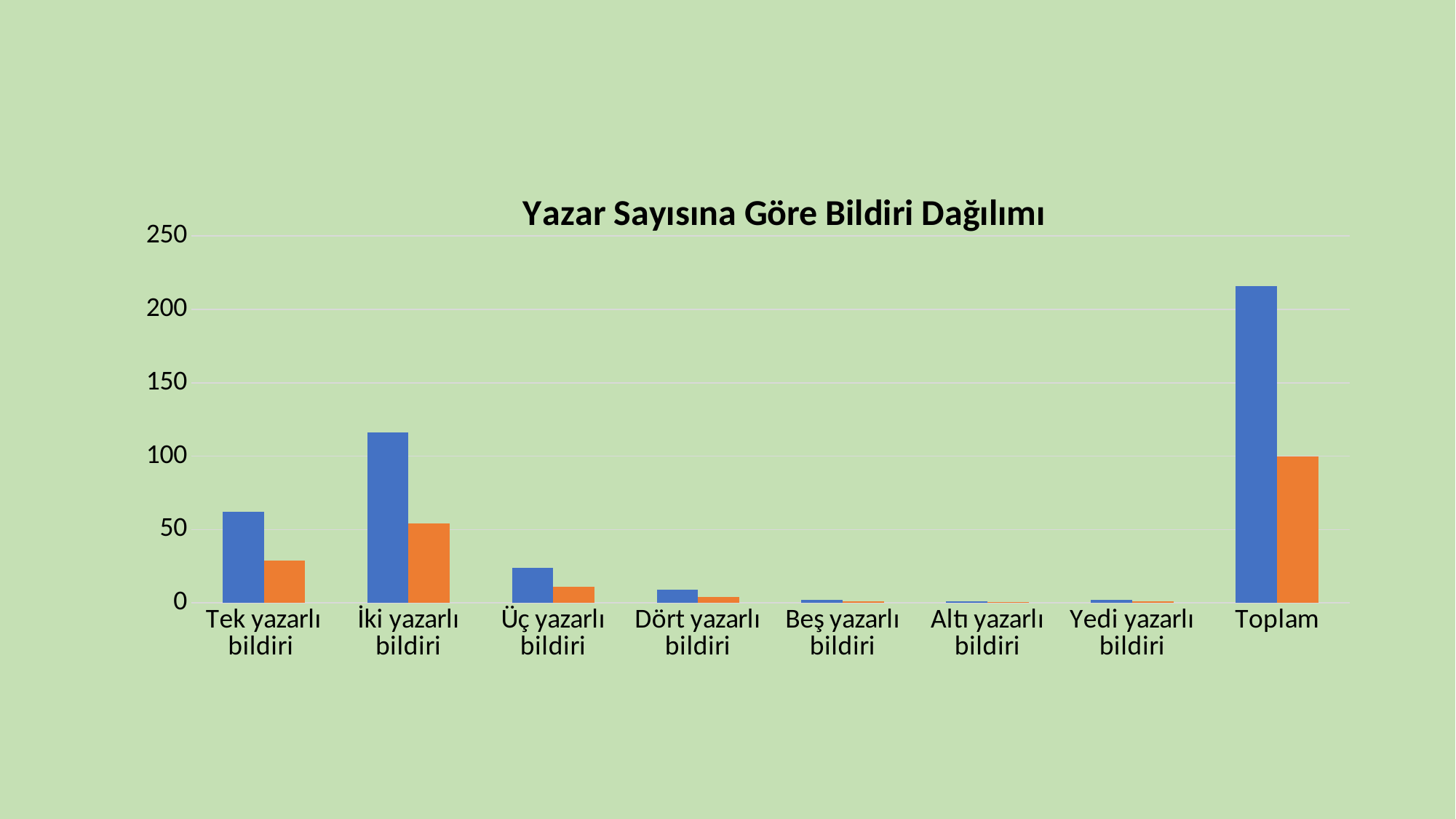
Is the blue bar for Toplam greater or less than 200? greater Which is larger, the orange bar for Tek yazarlı bildiri or the orange bar for Üç yazarlı bildiri? Tek yazarlı bildiri Excluding Toplam, which category has the tallest blue bar? İki yazarlı bildiri Is the blue bar for Üç yazarlı bildiri greater or less than 50? less What type of chart is shown on the slide? bar chart Is the orange bar for Tek yazarlı bildiri greater or less than 50? less Which is larger, the blue bar for Tek yazarlı bildiri or the blue bar for Üç yazarlı bildiri? Tek yazarlı bildiri What is the title of the chart? Yazar Sayısına Göre Bildiri Dağılımı Which category has the tallest blue bar? Toplam How many bars are plotted for each category in the chart? 2 How many categories are shown on the x axis of the chart? 8